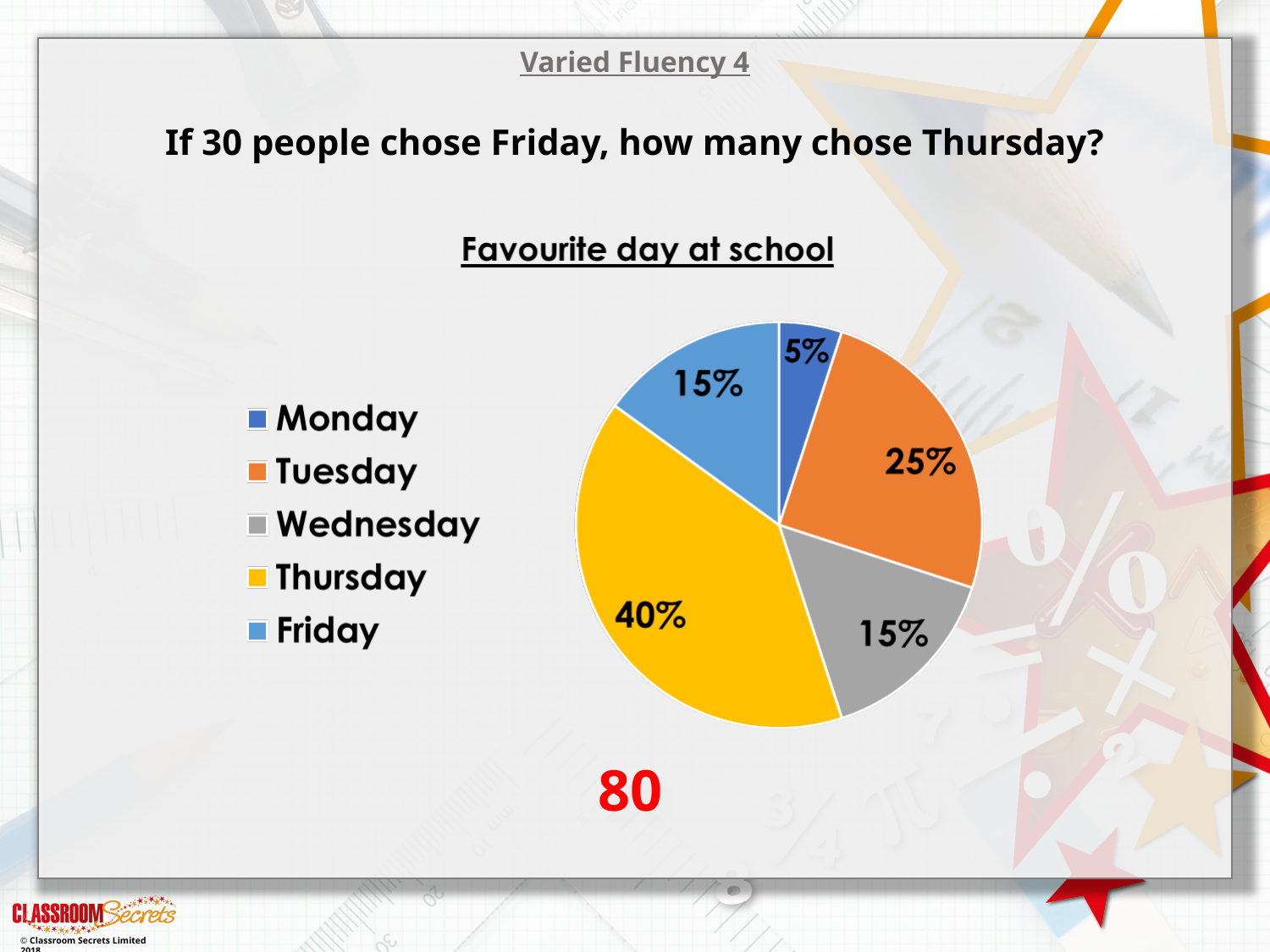
Which day has the smallest slice of the pie? Monday What kind of chart is shown on the slide? pie chart How many categories does the legend list? 5 Which day has the largest slice of the pie? Thursday Which is larger, the Tuesday slice or the Wednesday slice? Tuesday What percentage of the pie is Monday? 5% What is the combined share of Wednesday and Friday? 30% What percentage of the pie is Thursday? 40% What colour is the Thursday slice? yellow What is the difference in percentage points between Thursday and Tuesday? 15 What is the title of the chart? Favourite day at school What percentage of the pie is Tuesday? 25%